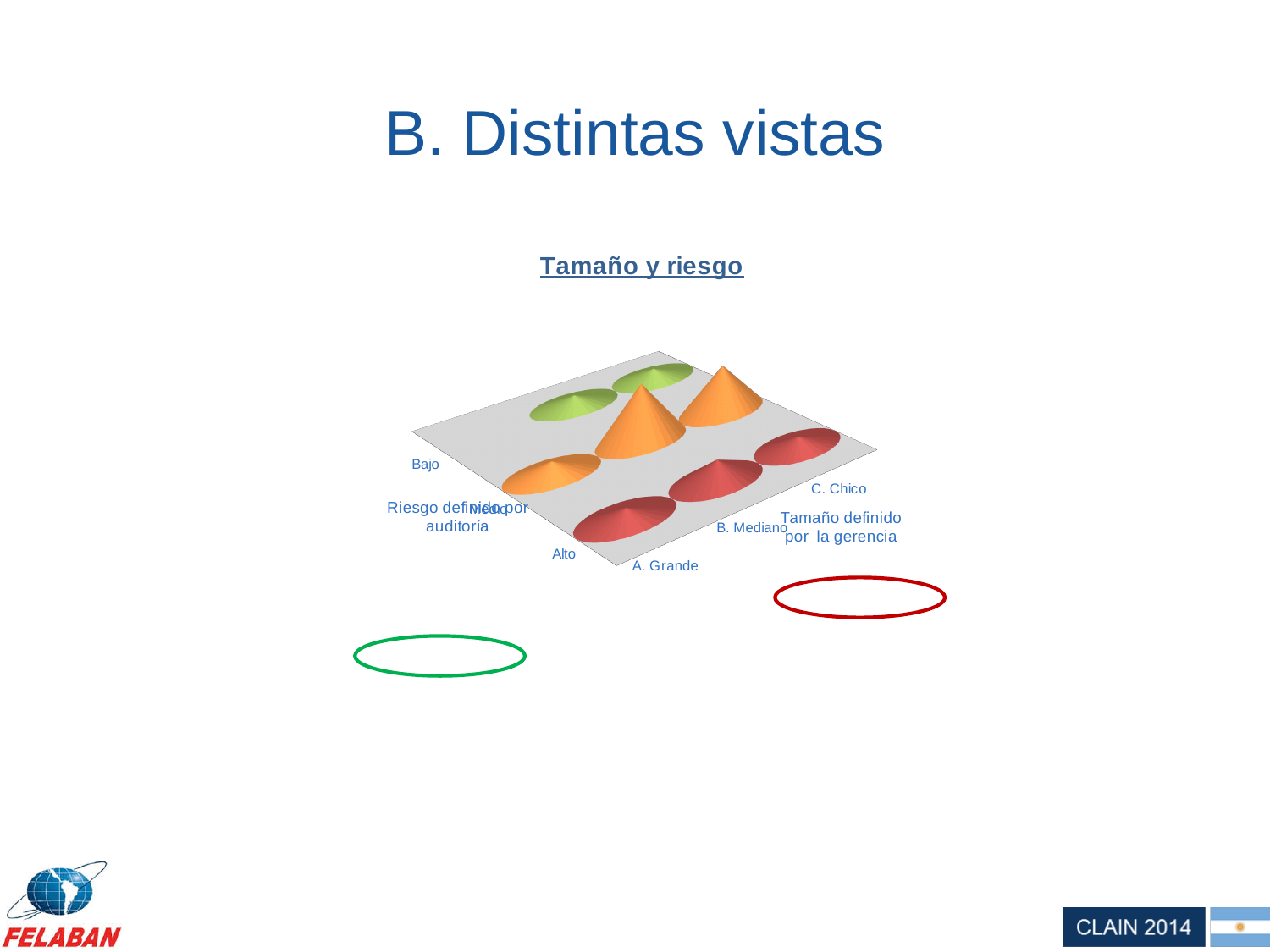
How many size categories (Tamaño definido por la gerencia) are shown on the chart? 3 How many risk levels (Riesgo definido por auditoría) are shown on the chart? 3 In the 'Medio' risk row, which is taller: the cone for A. Grande or the cone for B. Mediano? B. Mediano What colour are the cones in the 'Alto' risk row? Red Which risk level row contains the tallest cones? Medio What is the title of the chart? Tamaño y riesgo What kind of chart is shown on the slide? 3D bar chart (cone shapes)